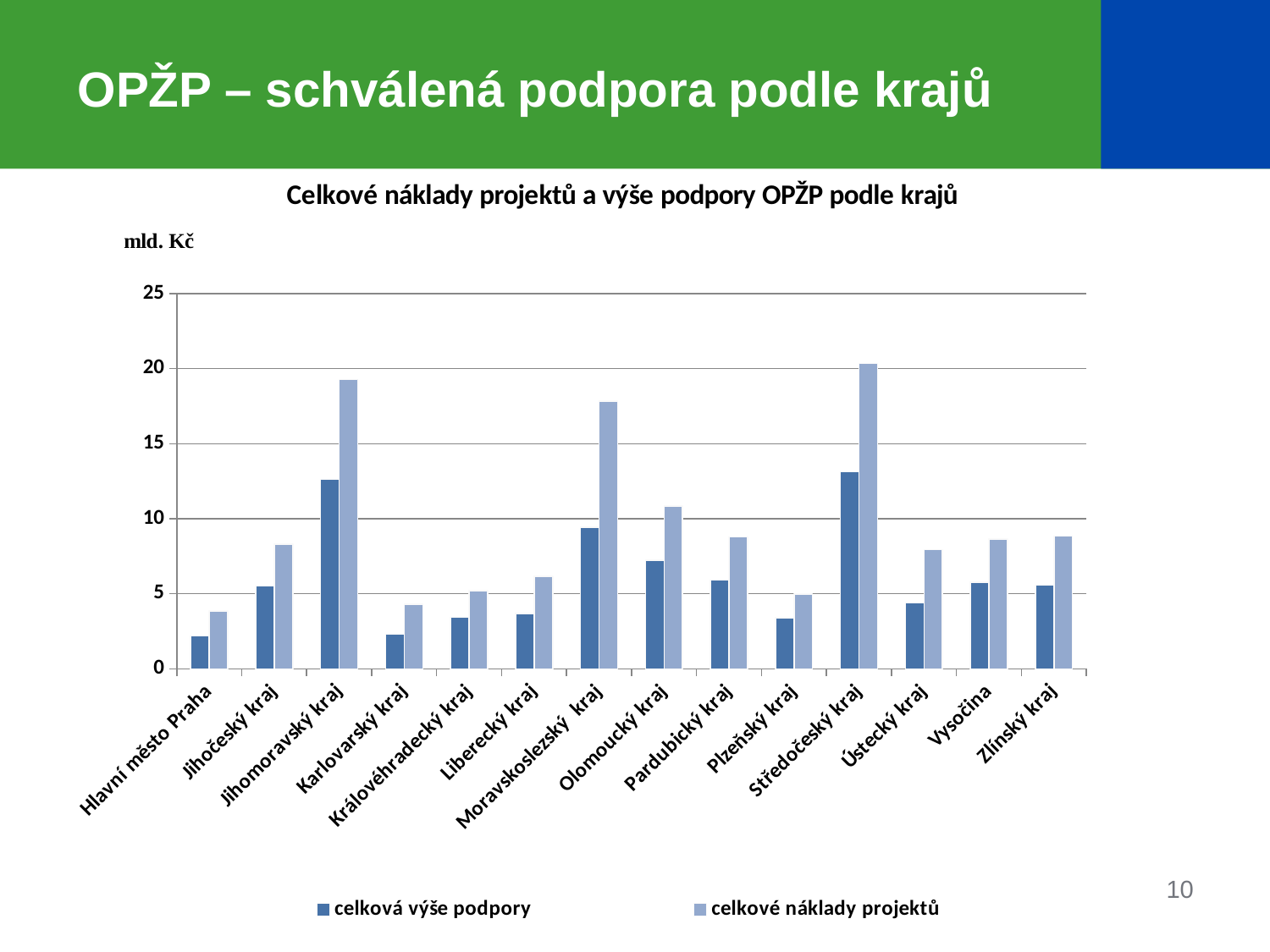
Which is larger: celkové náklady projektů for Moravskoslezský kraj or for Olomoucký kraj? Moravskoslezský kraj What unit is shown on the y axis of the chart? mld. Kč Is the value of celková výše podpory for Hlavní město Praha greater or less than 5? less Is the value of celková výše podpory for Jihomoravský kraj greater or less than 10? greater What kind of chart is shown on the slide? bar chart Is the value of celkové náklady projektů for Jihomoravský kraj greater or less than 15? greater Which region has the highest value for celkové náklady projektů? Středočeský kraj Which is larger: celková výše podpory for Olomoucký kraj or for Pardubický kraj? Olomoucký kraj How many regions (categories) are shown on the x axis? 14 How many series does the legend list? 2